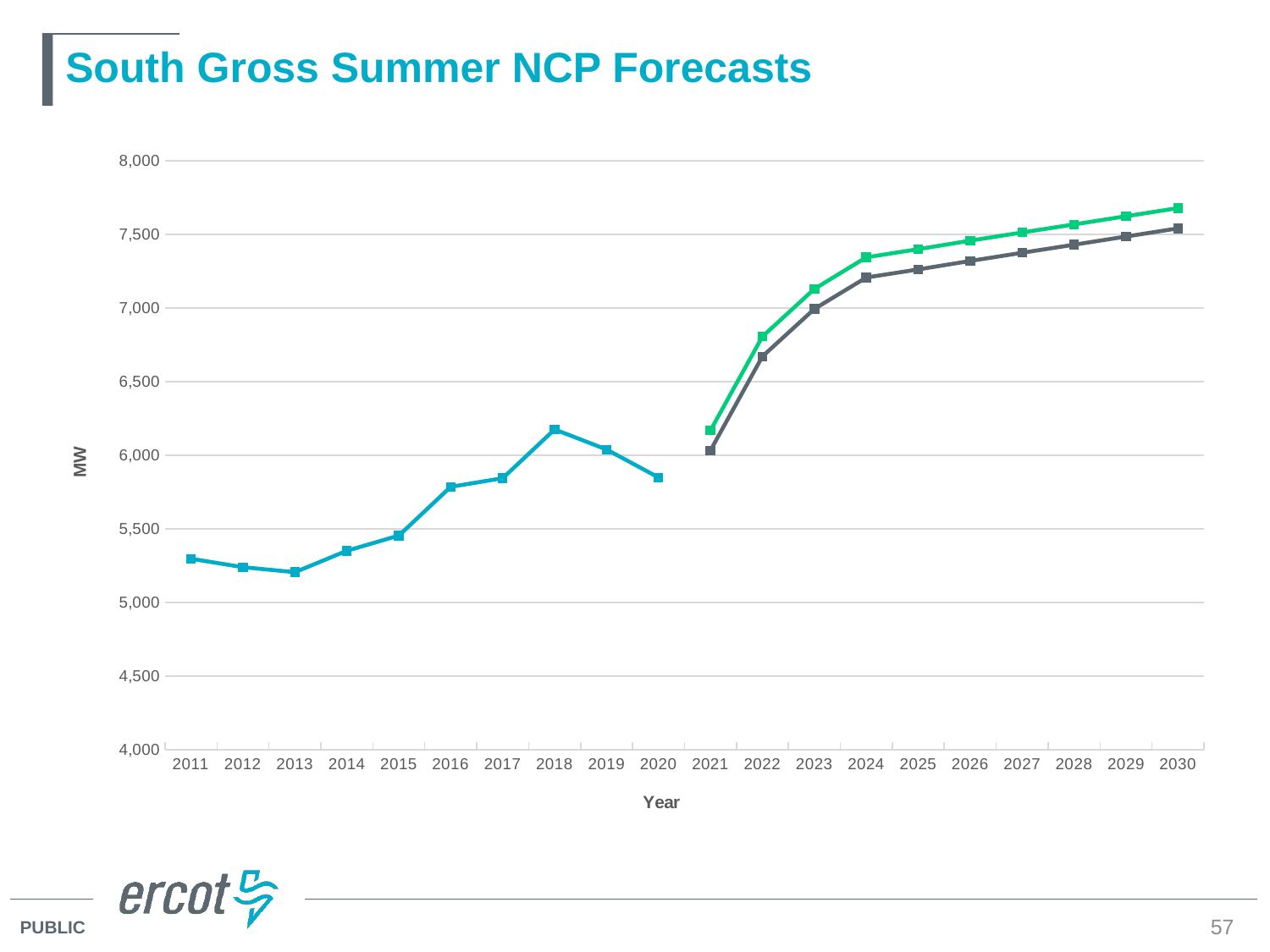
Is the value of the blue line for 2020 greater or less than 6,000? less In which year does the blue line reach its lowest value? 2013 Is the value of the green line for 2022 greater or less than 6,500? greater What is the label of the vertical axis? MW Is the value of the blue line for 2011 greater or less than 5,500? less What kind of chart is shown on the slide? line chart In which year does the blue line reach its highest value? 2018 Does the green line rise or fall from 2021 to 2030? rise In 2030, which line has the higher value, the green line or the dark gray line? green line What is the title of the chart? South Gross Summer NCP Forecasts How many years are shown on the x axis? 20